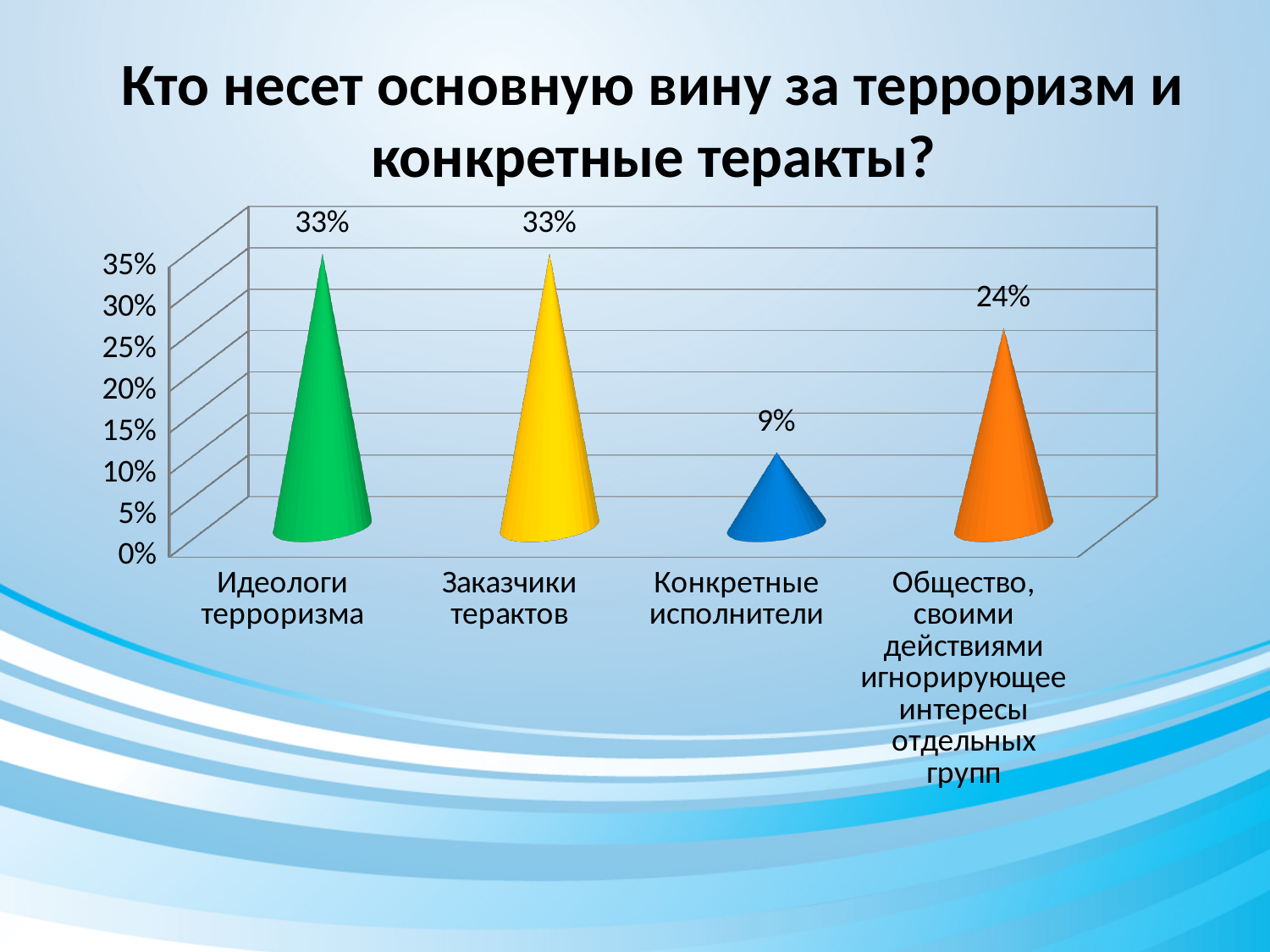
What is the value for Идеологи терроризма? 33% What is the difference between the values for Идеологи терроризма and Общество, своими действиями игнорирующее интересы отдельных групп? 9% What is the difference between the values for Заказчики терактов and Конкретные исполнители? 24% What is the value for Заказчики терактов? 33% Is the value for Общество, своими действиями игнорирующее интересы отдельных групп greater or less than 20%? greater What is the title of the chart? Кто несет основную вину за терроризм и конкретные теракты? How many categories are shown on the chart? 4 What is the value for Конкретные исполнители? 9% What kind of chart is shown on the slide? bar chart Which is larger: the value for Общество, своими действиями игнорирующее интересы отдельных групп or the value for Конкретные исполнители? Общество, своими действиями игнорирующее интересы отдельных групп Which category has the lowest value? Конкретные исполнители What is the value for Общество, своими действиями игнорирующее интересы отдельных групп? 24%